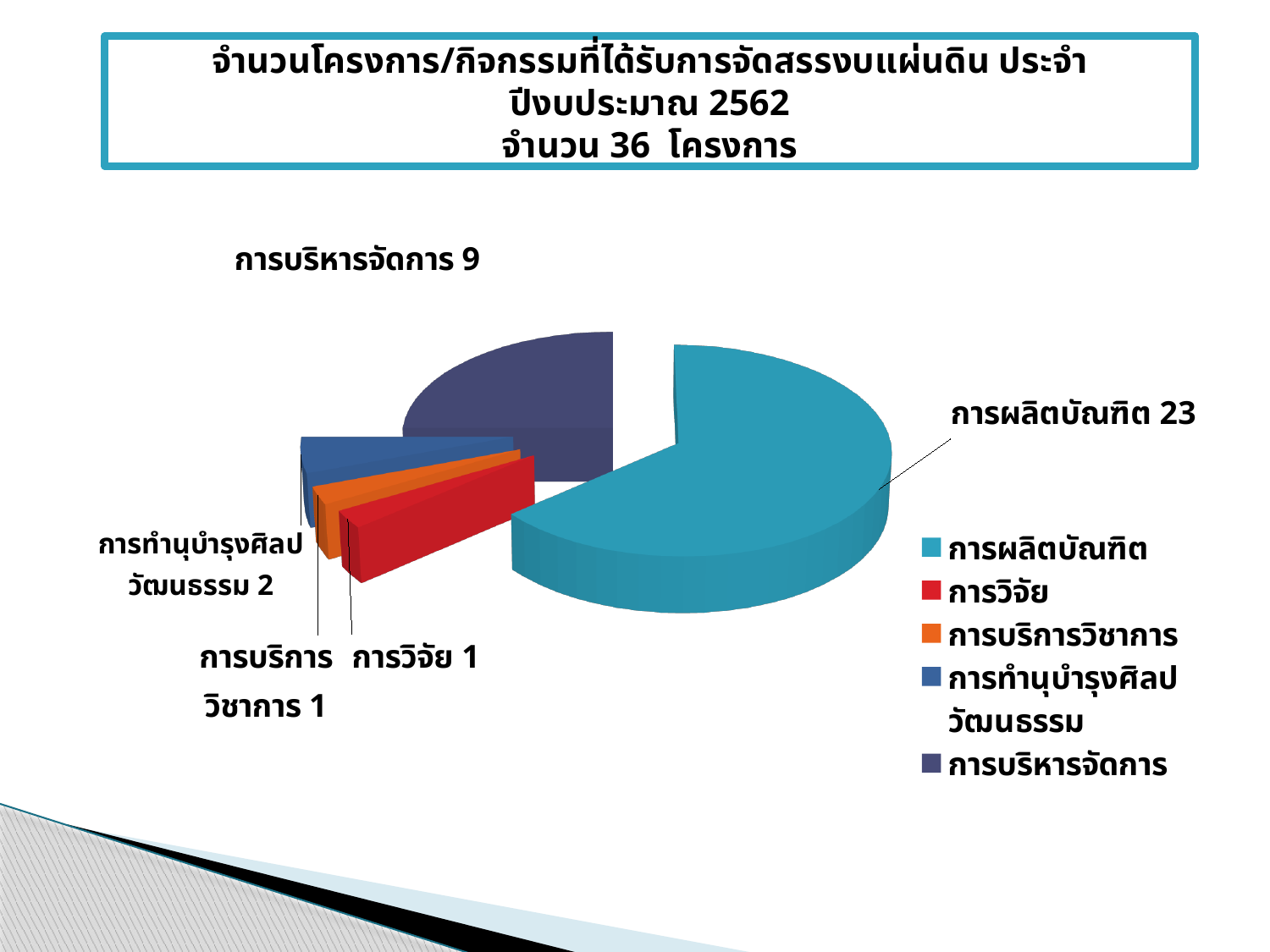
What kind of chart is shown on the slide? pie chart What colour is the slice for การผลิตบัณฑิต? teal/light blue How many projects are shown for การทำนุบำรุงศิลปวัฒนธรรม? 2 How many projects are shown for การบริหารจัดการ? 9 Which category has the largest slice of the pie? การผลิตบัณฑิต What share of the pie does การบริหารจัดการ represent? 25% Which is larger, the value for การบริหารจัดการ or the value for การทำนุบำรุงศิลปวัฒนธรรม? การบริหารจัดการ What is the difference between the values for การผลิตบัณฑิต and การบริหารจัดการ? 14 How many projects are shown for การผลิตบัณฑิต? 23 What is the total number of projects across all slices of the pie? 36 How many projects are shown for การวิจัย? 1 How many categories does the pie chart have? 5